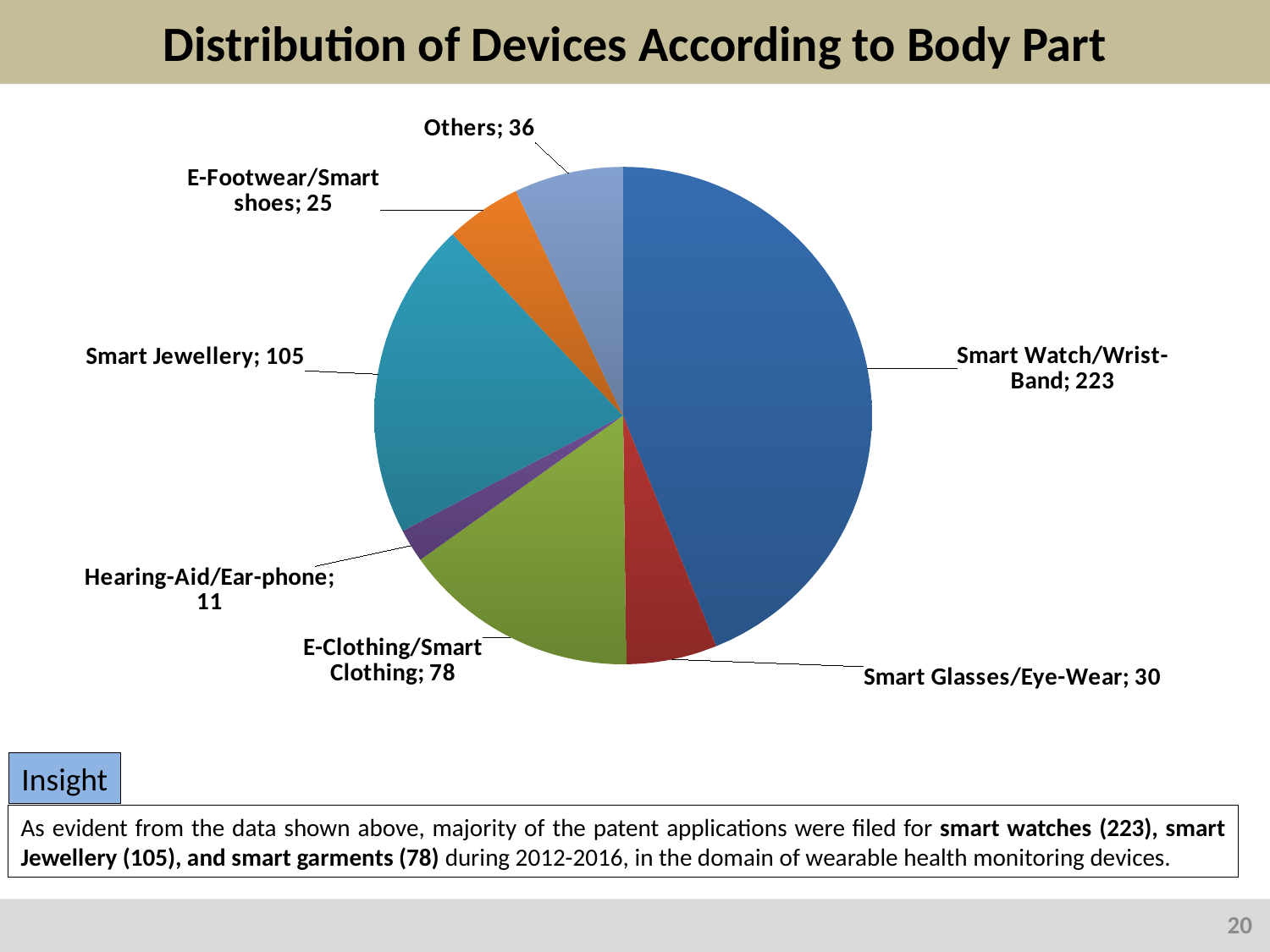
How many categories are shown in the pie chart? 7 What is the difference between the values for Smart Watch/Wrist-Band and Smart Jewellery? 118 Which is larger, the value for Others or the value for Smart Glasses/Eye-Wear? Others What is the title of the chart on the slide? Distribution of Devices According to Body Part What is the value for E-Footwear/Smart shoes in the pie chart? 25 What is the value for Smart Watch/Wrist-Band in the pie chart? 223 What is the value for Hearing-Aid/Ear-phone in the pie chart? 11 What is the difference between the values for E-Clothing/Smart Clothing and Smart Glasses/Eye-Wear? 48 Which category has the largest slice in the pie chart? Smart Watch/Wrist-Band Which category has the smallest slice in the pie chart? Hearing-Aid/Ear-phone What kind of chart is shown on the slide? Pie chart What is the value for Smart Jewellery in the pie chart? 105